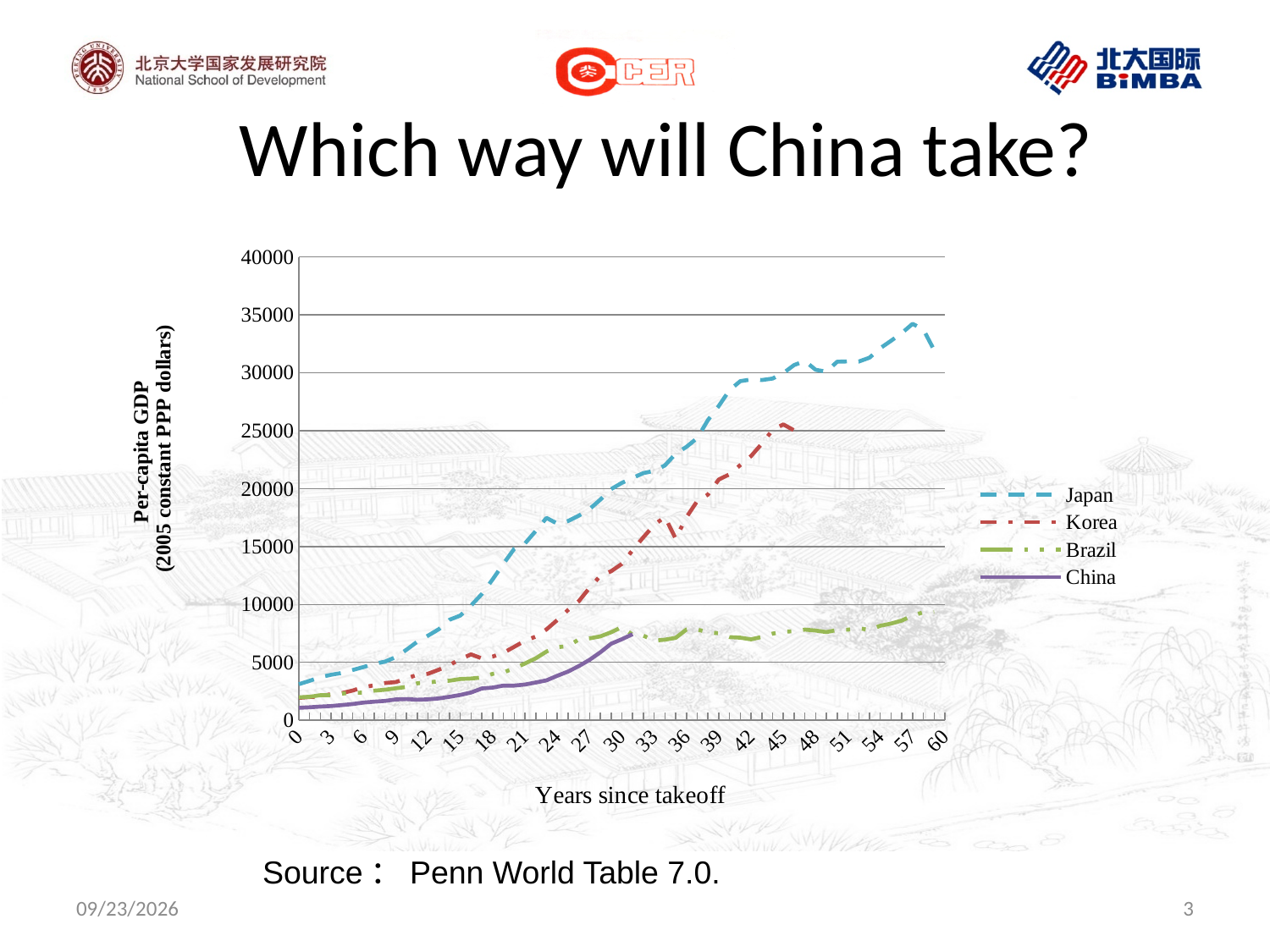
Is the value for Japan at 0 years since takeoff greater or less than 5000? less How many series does the legend list? 4 Does the Japan series generally rise or fall as years since takeoff increase? rise At 36 years since takeoff, which is higher, Korea or Brazil? Korea Which series reaches the highest per-capita GDP on the chart? Japan Is the value for Korea at 45 years since takeoff greater or less than 20000? greater Is the value for China at 30 years since takeoff greater or less than 10000? less What is the label of the x axis? Years since takeoff What kind of chart is shown on the slide? line chart Which series are listed in the legend? Japan, Korea, Brazil, China